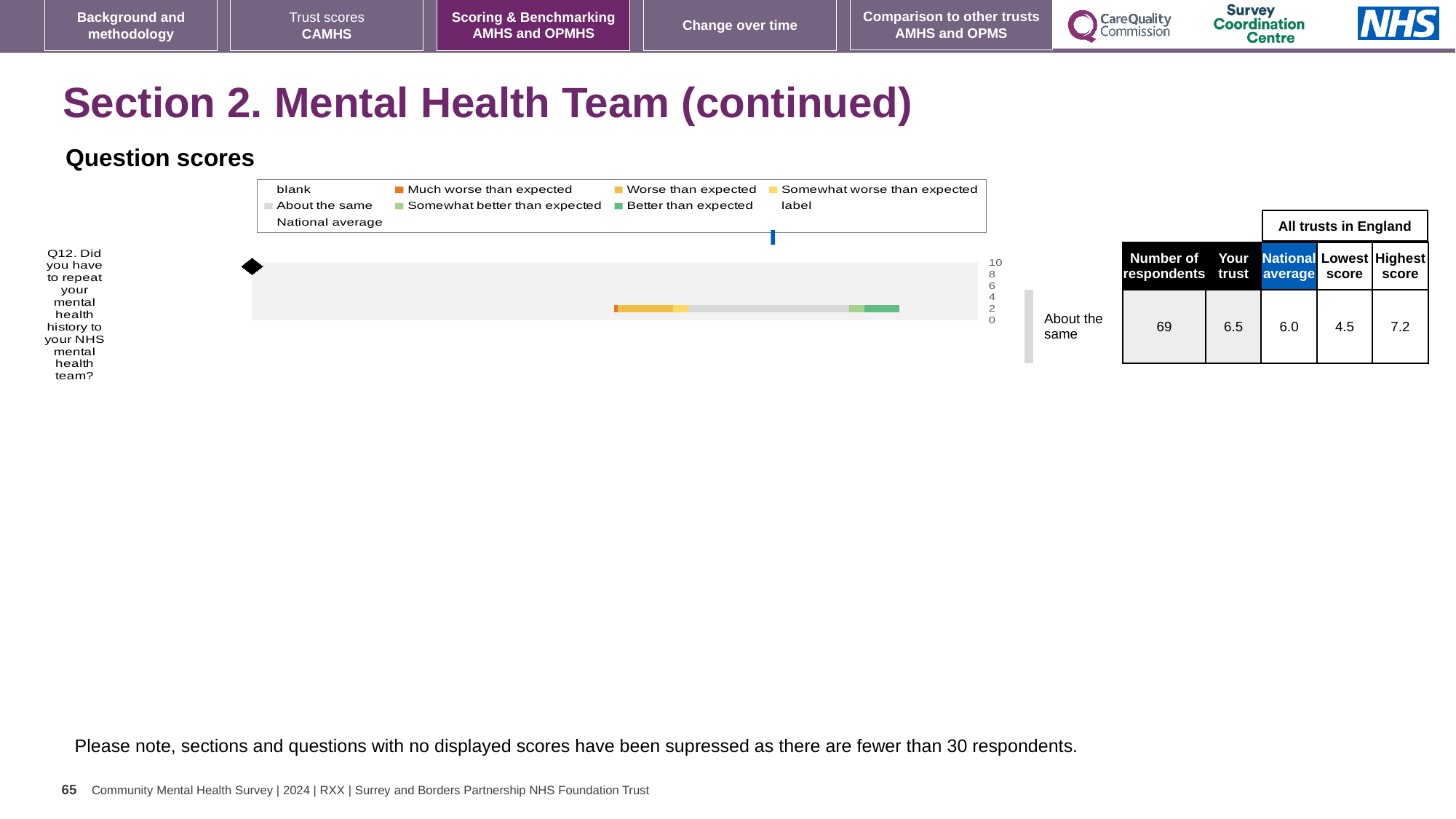
What is the highest score among all trusts in England for Q12? 7.2 What is the national average score for Q12? 6.0 What benchmark category label is shown next to the Q12 bar? About the same What is the 'Your trust' score for Q12? 6.5 What is the difference between the highest score and the lowest score among all trusts in England for Q12? 2.7 What kind of chart is used to show the question scores for Q12? bar chart What is the number of respondents for Q12? 69 How many questions are plotted in the question scores chart? 1 What is the lowest score among all trusts in England for Q12? 4.5 Which question is shown in the question scores chart? Q12. Did you have to repeat your mental health history to your NHS mental health team? What is the highest value shown on the chart's score axis? 10 Which is larger for Q12, the 'Your trust' score or the national average? Your trust